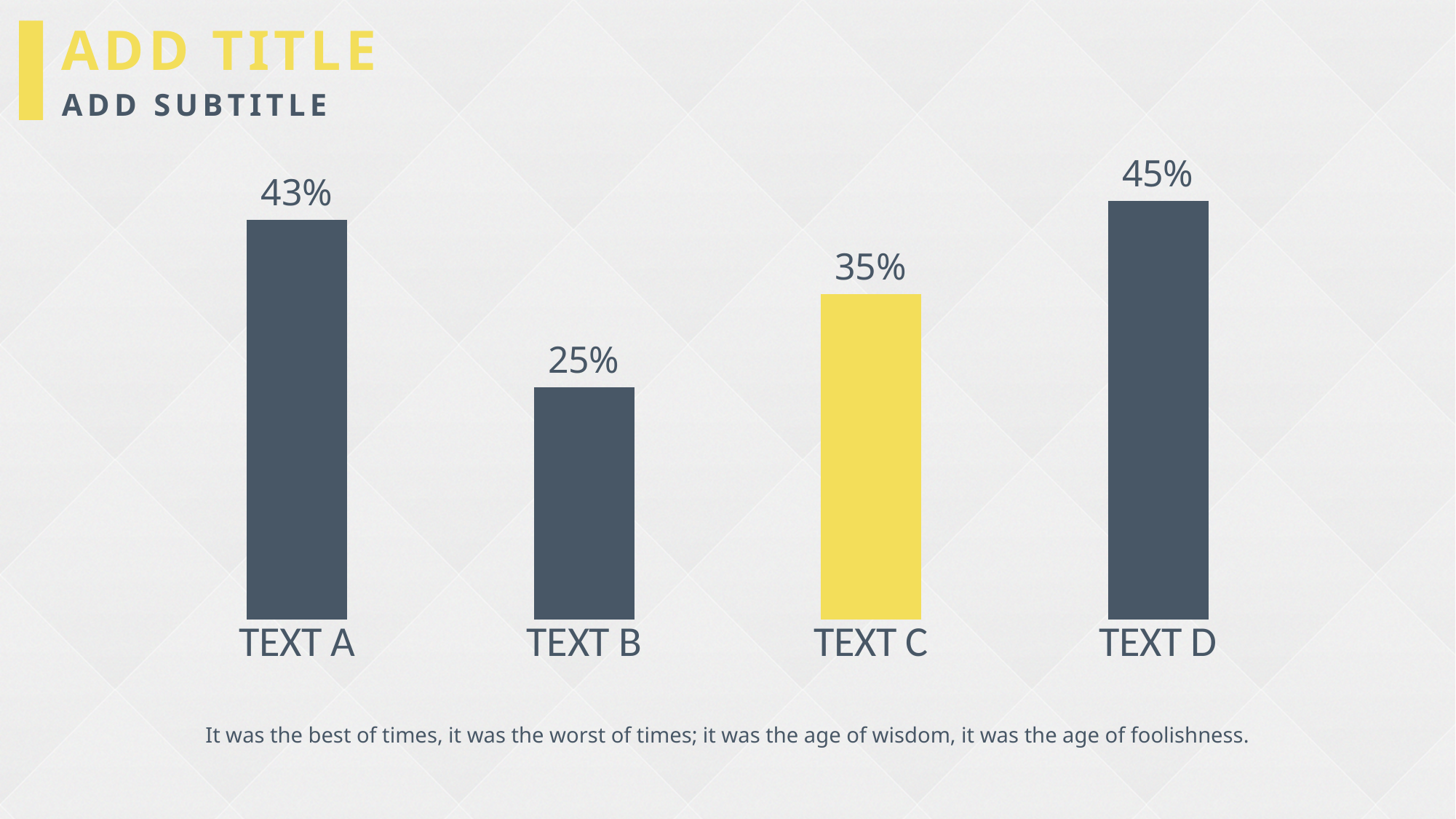
Which category's bar is coloured yellow? TEXT C What is the difference between the values for TEXT D and TEXT B? 20% Which category has the lowest value? TEXT B What is the value for TEXT A? 43% What is the value for TEXT B? 25% What is the difference between the values for TEXT A and TEXT C? 8% What is the value for TEXT D? 45% What kind of chart is shown on the slide? Bar chart What is the value for TEXT C? 35% Which category has the highest value? TEXT D Which is larger, the value for TEXT A or the value for TEXT C? TEXT A How many categories are shown in the chart? 4